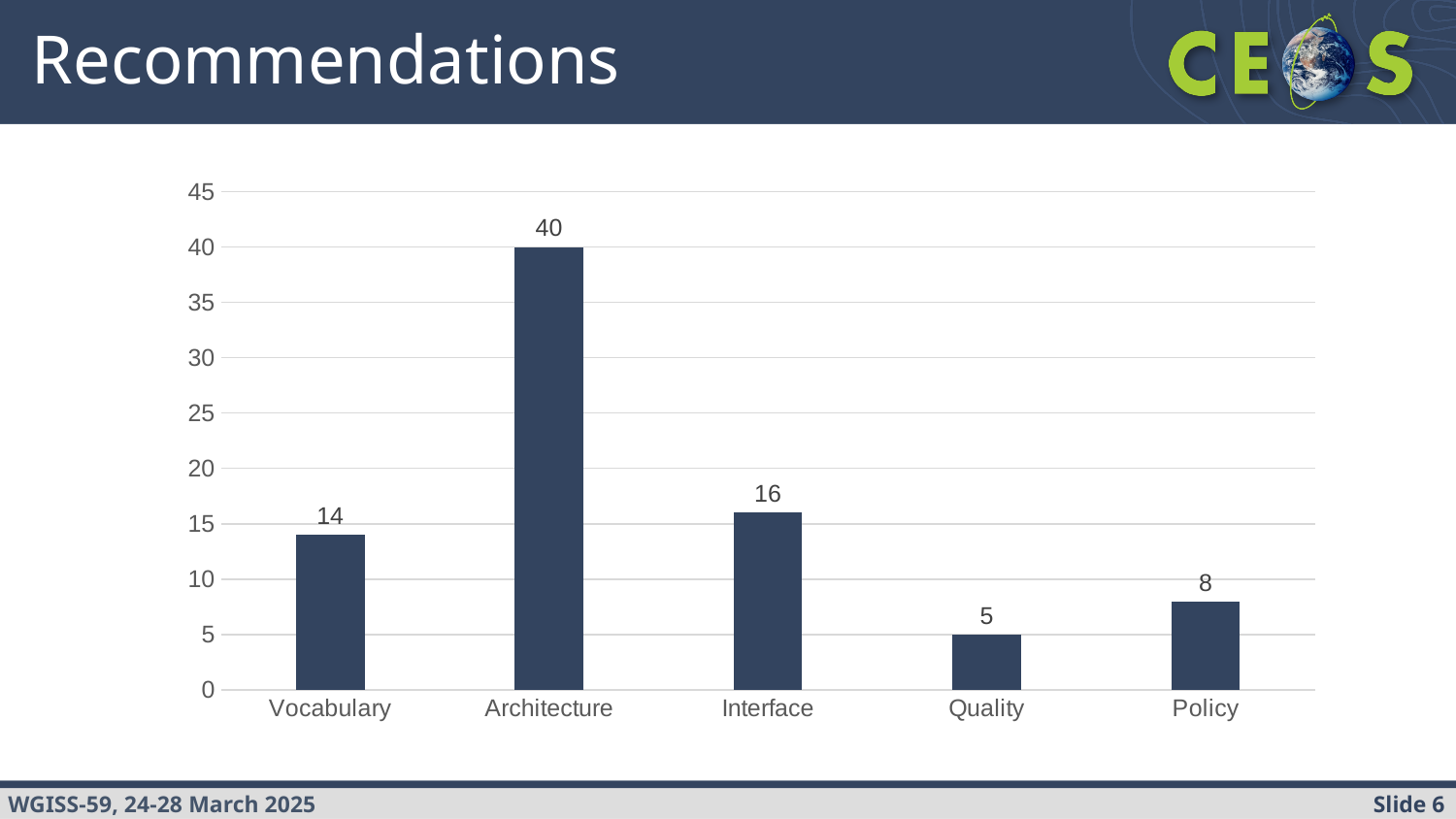
What kind of chart is shown on the slide? bar chart How many categories are shown on the x axis? 5 What is the difference between the values for Architecture and Interface? 24 Is the value for Policy greater or less than 10? less Which category has the lowest value? Quality What is the value for Vocabulary? 14 What is the value for Architecture? 40 Which category has the highest value? Architecture What is the value for Policy? 8 What is the difference between the values for Vocabulary and Policy? 6 Which is larger, the value for Interface or the value for Vocabulary? Interface What is the value for Quality? 5